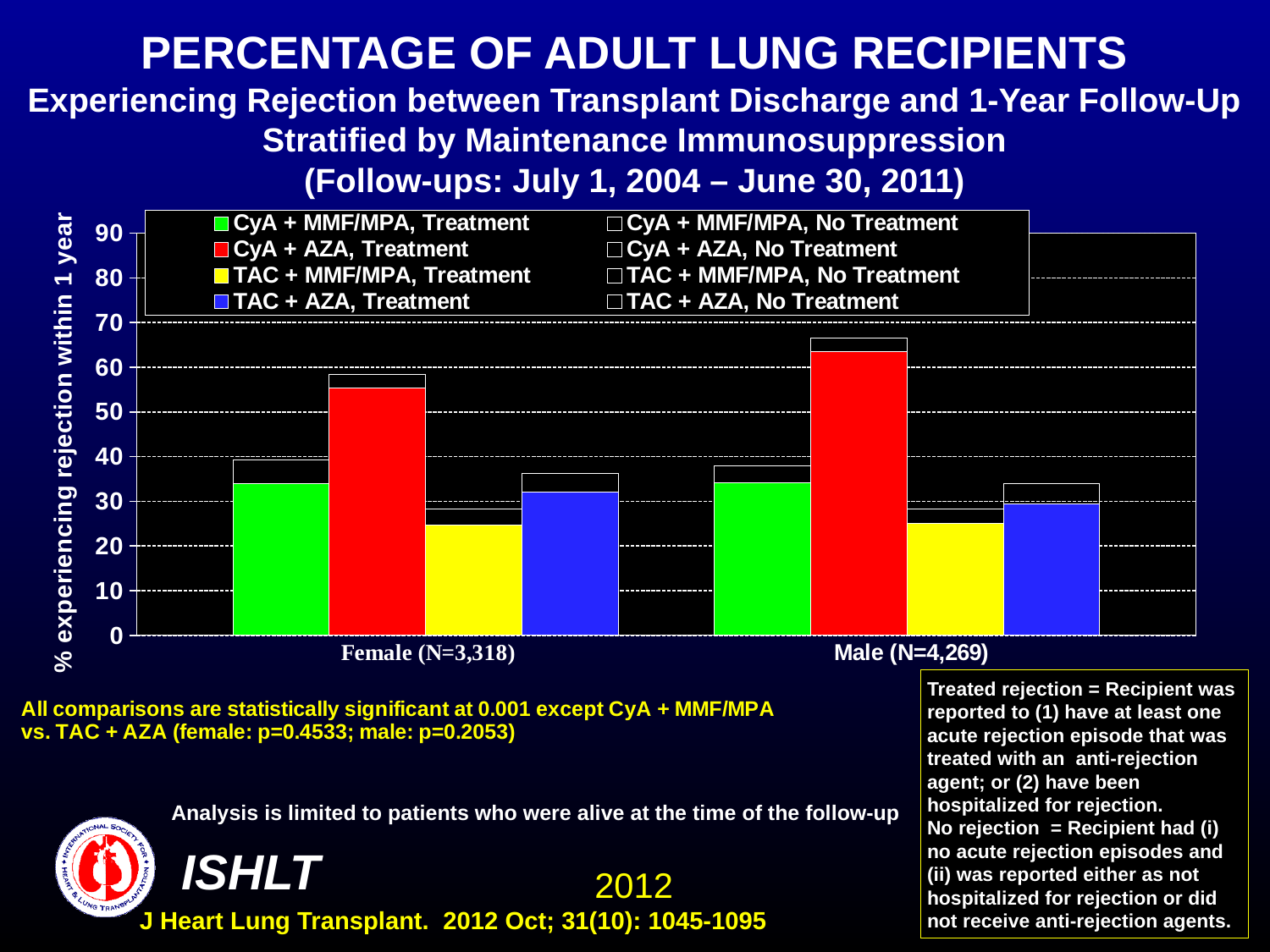
What is the N shown for the Male category? N=4,269 How many series does the chart legend list? 8 Which maintenance immunosuppression regimen has the tallest bar in the Female group? CyA + AZA Is the CyA + AZA, Treatment value for Male greater or less than 60? greater What is the label of the y axis? % experiencing rejection within 1 year What kind of chart is shown on the slide? bar chart Is the CyA + MMF/MPA, Treatment value for Male greater or less than 40? less Which maintenance immunosuppression regimen has the shortest bar in the Male group? TAC + MMF/MPA Is the CyA + AZA, Treatment value larger for Female or for Male? Male How many categories are shown on the x axis? 2 Is the TAC + MMF/MPA, Treatment value for Female greater or less than 30? less